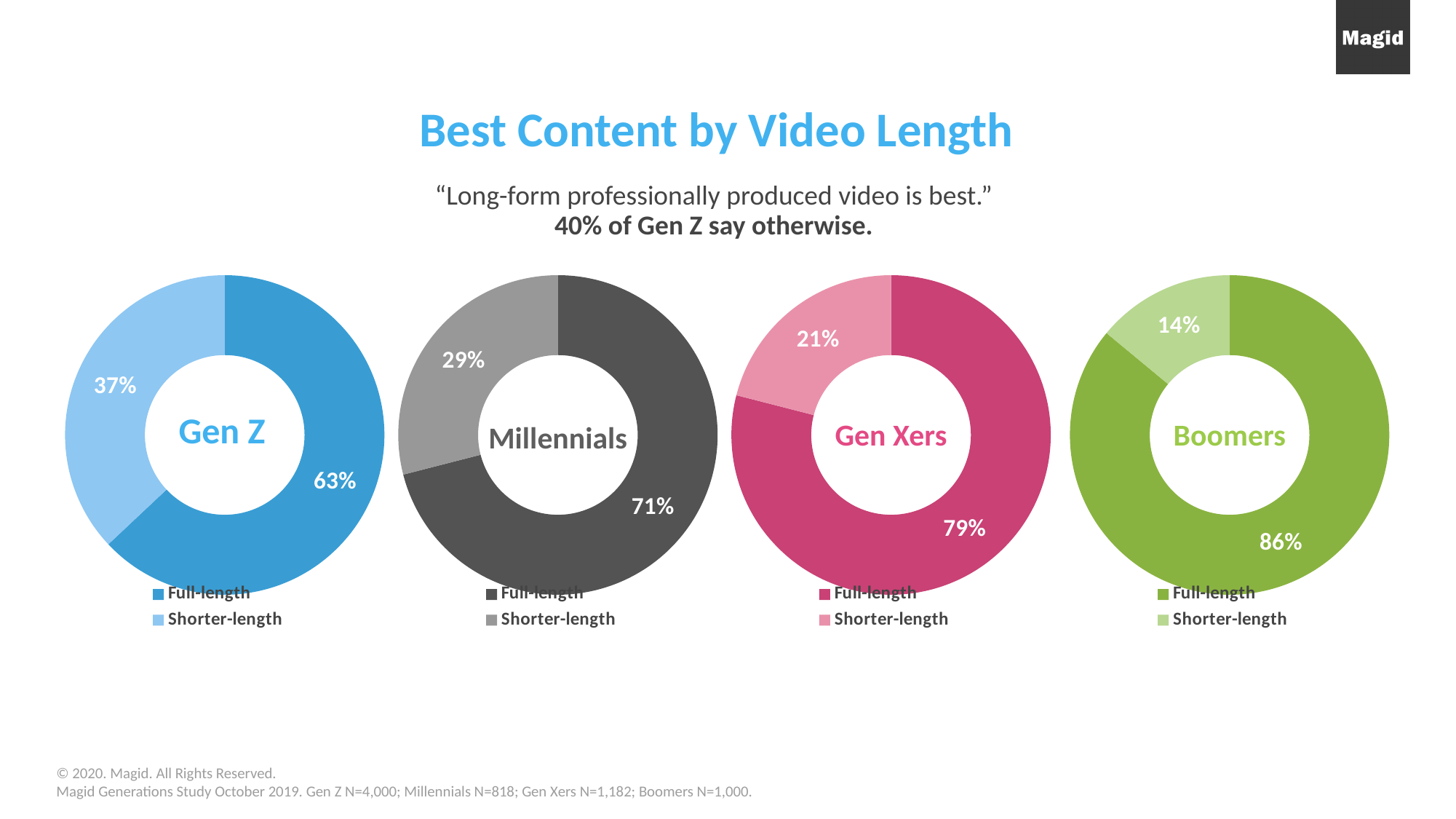
How many entries does the legend of the Boomers chart list? 2 What is the title of the slide's chart section? Best Content by Video Length In the Boomers chart, what percentage is shown for Shorter-length? 14% How many donut charts are on the slide? 4 In the Gen Xers chart, what percentage is shown for Full-length? 79% Across the four charts, which generation has the lowest Full-length share? Gen Z Which is larger: the Shorter-length share for Millennials or the Shorter-length share for Gen Xers? Millennials In the Gen Z chart, what percentage is shown for Full-length? 63% What type of chart is used for Gen Xers? Donut (pie) chart In the Millennials chart, what percentage is shown for Shorter-length? 29% In the Gen Z chart, what is the difference between the Full-length and Shorter-length percentages? 26% Across the four charts, which generation has the highest Full-length share? Boomers